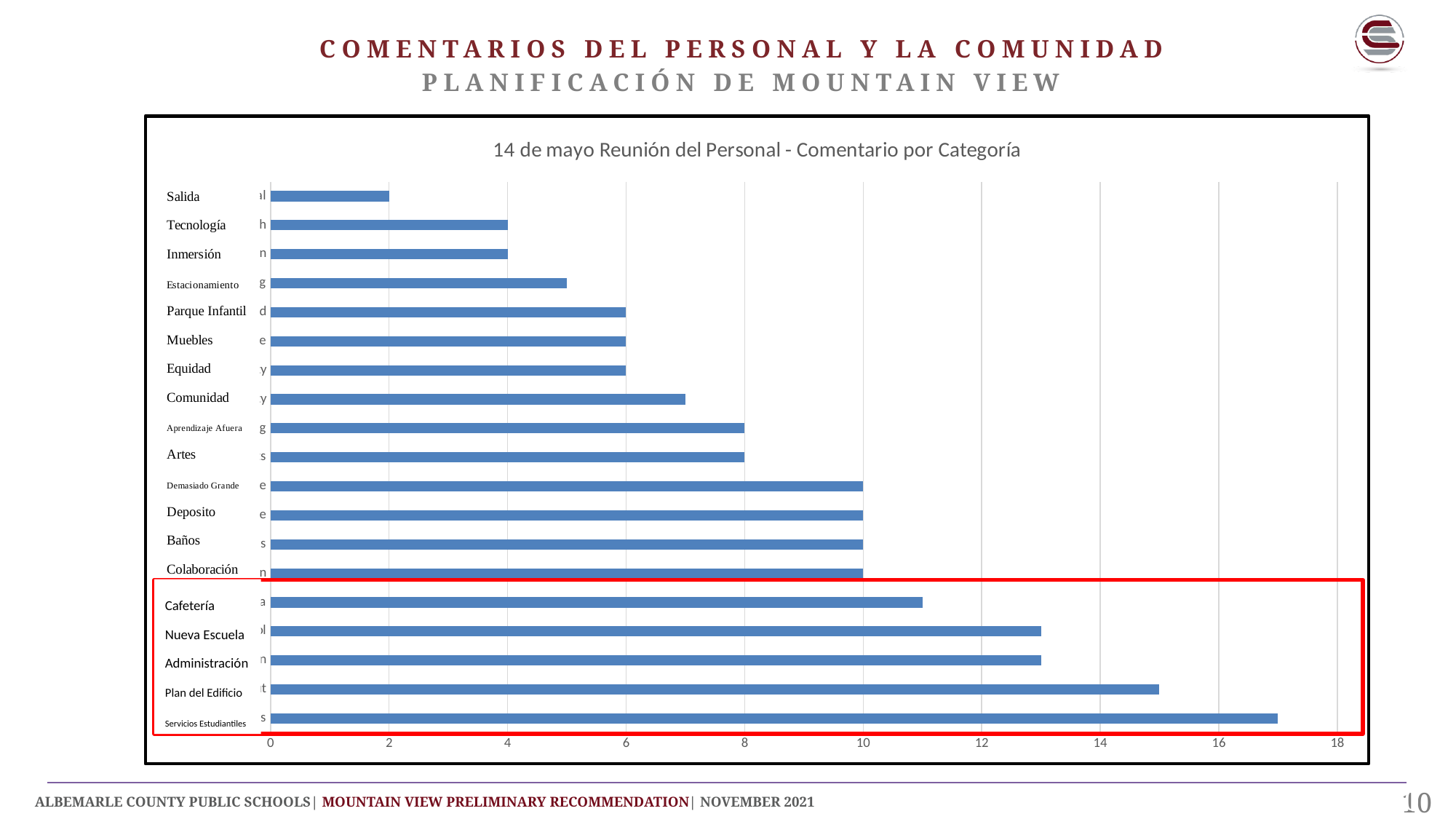
What kind of chart is shown on the slide? Bar chart Is the value for Servicios Estudiantiles greater or less than 16? greater Which category has the lowest value? Salida Which is larger, the value for Artes or the value for Tecnología? Artes Which category has the highest value? Servicios Estudiantiles What is the value for Colaboración? 10 What is the difference between the values for Colaboración and Salida? 8 What is the value for Tecnología? 4 How many categories are plotted in the chart? 19 What is the value for Salida? 2 What is the title of the chart? 14 de mayo Reunión del Personal - Comentario por Categoría Is the value for Plan del Edificio greater or less than 16? less